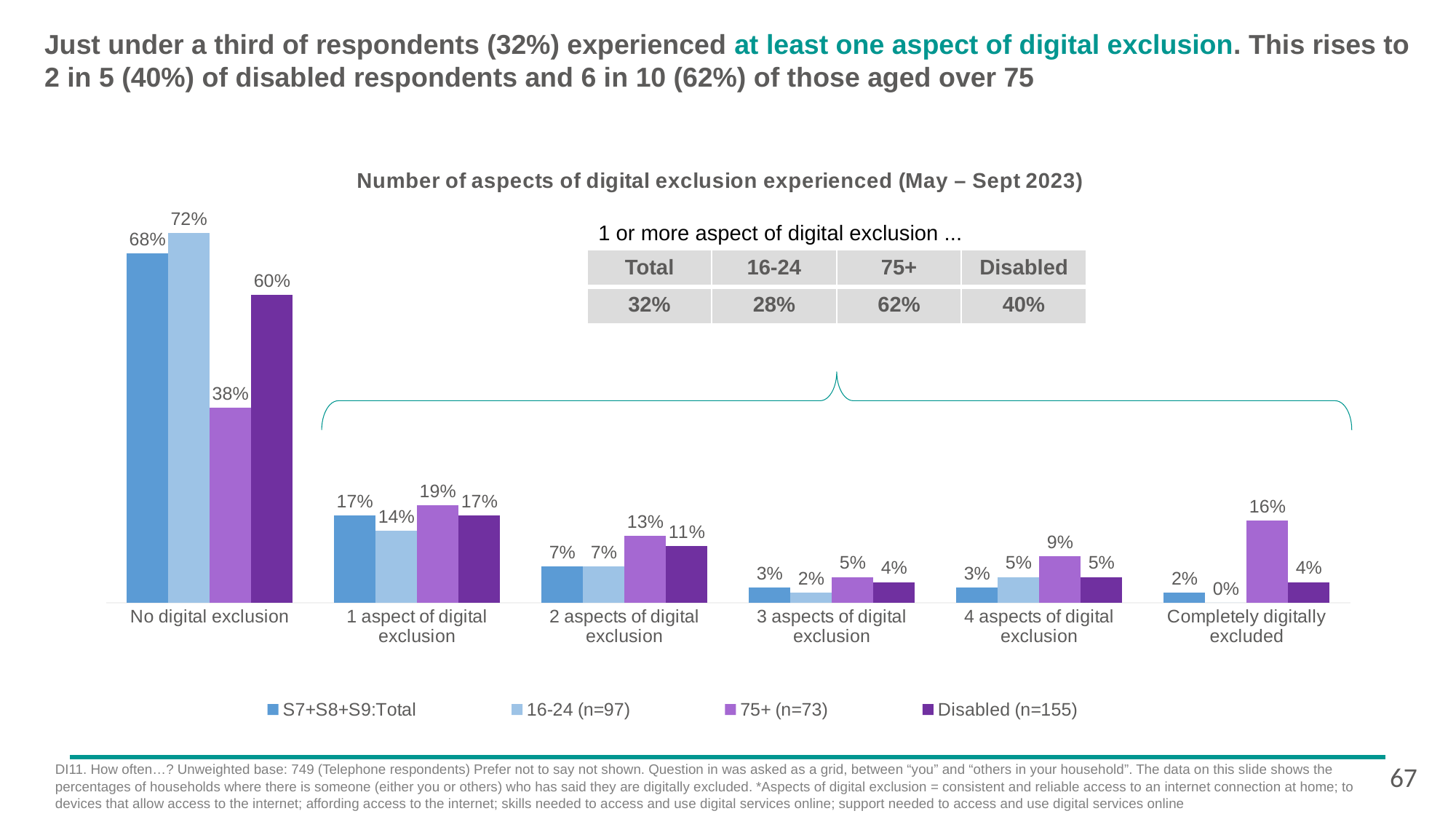
What is the value for the 75+ (n=73) series in the 'No digital exclusion' category? 38% What is the value for the Disabled (n=155) series in the 'Completely digitally excluded' category? 4% What kind of chart is shown on the slide? Bar chart What is the title of the chart? Number of aspects of digital exclusion experienced (May – Sept 2023) Which series has the lowest value in the 'Completely digitally excluded' category? 16-24 (n=97) In the '4 aspects of digital exclusion' category, which is larger: the 75+ (n=73) value or the Disabled (n=155) value? 75+ (n=73) What is the value for the 16-24 (n=97) series in the '2 aspects of digital exclusion' category? 7% According to the table on the slide, what percentage of 75+ respondents experienced 1 or more aspect of digital exclusion? 62% How many categories are shown on the x axis of the chart? 6 What is the difference between the 16-24 (n=97) and 75+ (n=73) values in the 'No digital exclusion' category? 34% Which series has the highest value in the 'No digital exclusion' category? 16-24 (n=97) How many series does the chart legend list? 4